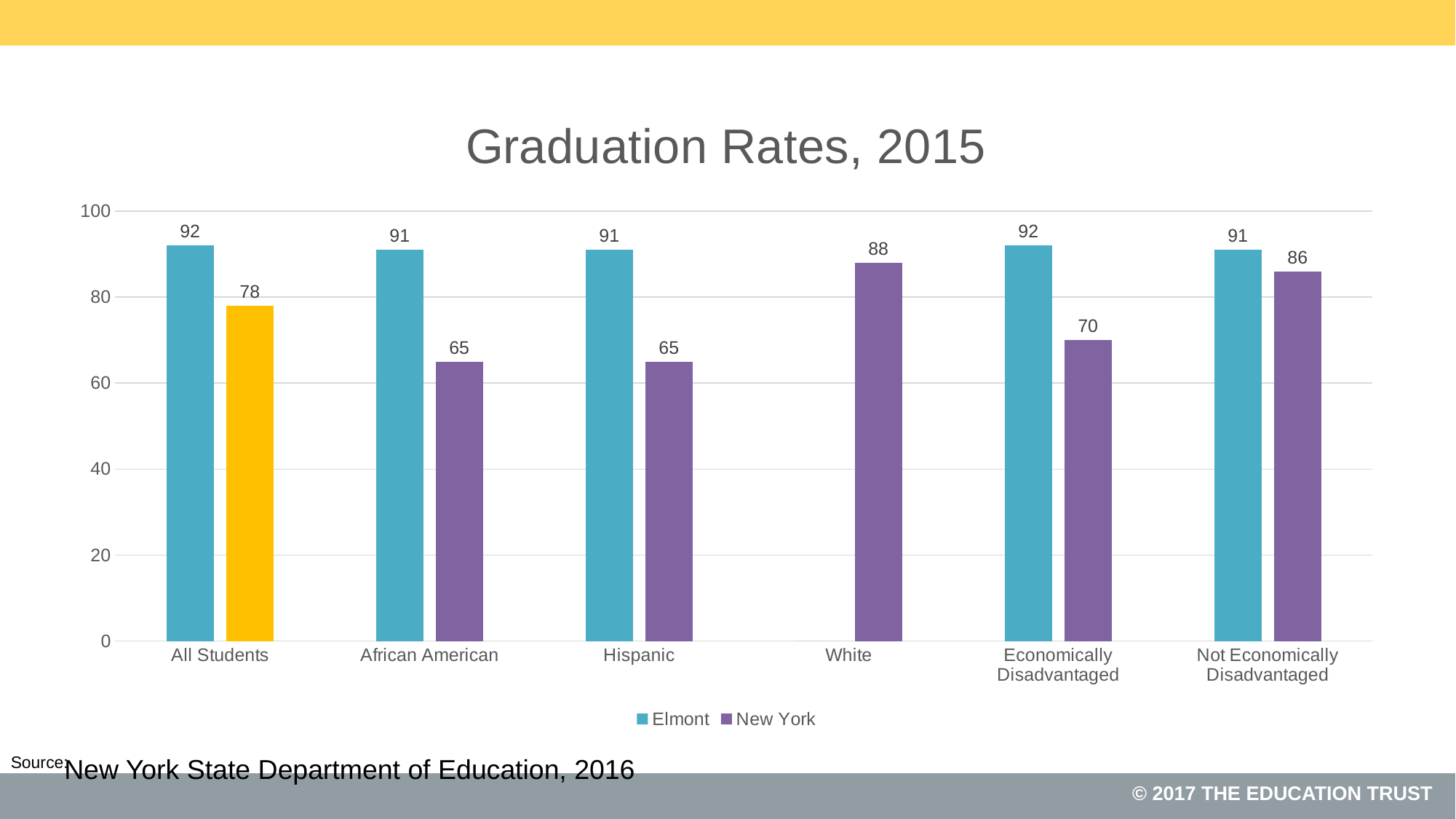
What type of chart is shown on the slide? Bar chart Which is larger, the New York graduation rate for All Students or for Not Economically Disadvantaged students? Not Economically Disadvantaged How many series does the legend list? 2 What is the New York graduation rate for White students? 88 Which category has the lowest New York graduation rate? African American and Hispanic (both 65) Which category has the highest New York graduation rate? White What is the Elmont graduation rate for Economically Disadvantaged students? 92 What is the difference between the Elmont and New York graduation rates for Hispanic students? 26 What is the New York graduation rate for African American students? 65 What is the Elmont graduation rate for All Students? 92 What is the difference between the Elmont and New York graduation rates for Economically Disadvantaged students? 22 How many categories are shown on the x axis? 6